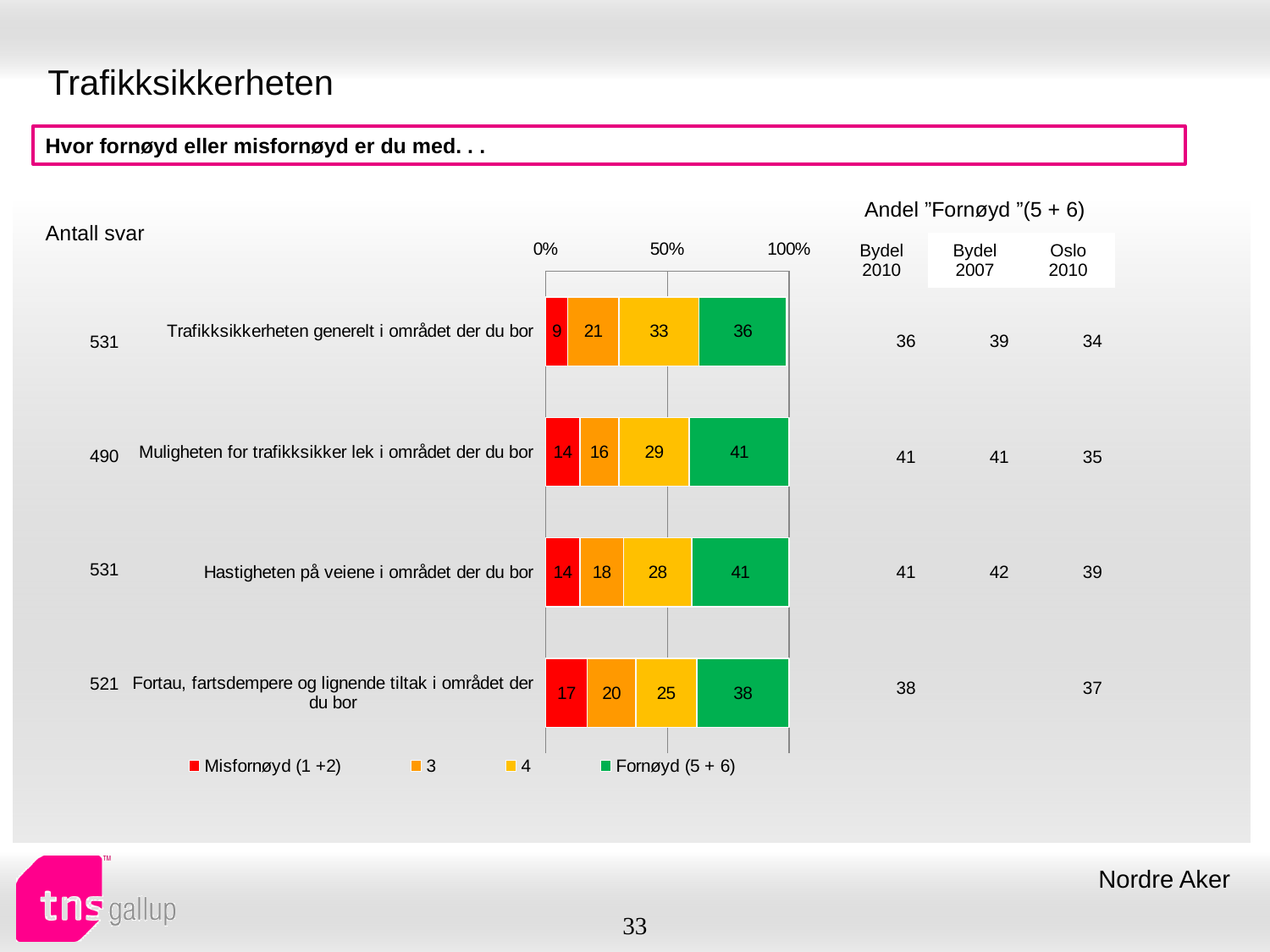
What is the value of series '4' for 'Muligheten for trafikksikker lek i området der du bor'? 29 Which is larger: the series '3' value for 'Trafikksikkerheten generelt i området der du bor' or for 'Hastigheten på veiene i området der du bor'? Trafikksikkerheten generelt i området der du bor What is the 'Misfornøyd (1 +2)' value for 'Fortau, fartsdempere og lignende tiltak i området der du bor'? 17 How many series does the chart legend list? 4 What kind of chart is shown on the slide? stacked bar chart What is the difference between the 'Fornøyd (5 + 6)' values for 'Hastigheten på veiene i området der du bor' and 'Trafikksikkerheten generelt i området der du bor'? 5 What is the total of the stacked bar for 'Muligheten for trafikksikker lek i området der du bor'? 100 Which category has the lowest 'Misfornøyd (1 +2)' value? Trafikksikkerheten generelt i området der du bor Which category has the highest 'Misfornøyd (1 +2)' value? Fortau, fartsdempere og lignende tiltak i området der du bor How many categories (questions) are plotted in the chart? 4 What is the 'Fornøyd (5 + 6)' value for 'Trafikksikkerheten generelt i området der du bor'? 36 What colour represents the 'Fornøyd (5 + 6)' series in the chart? green